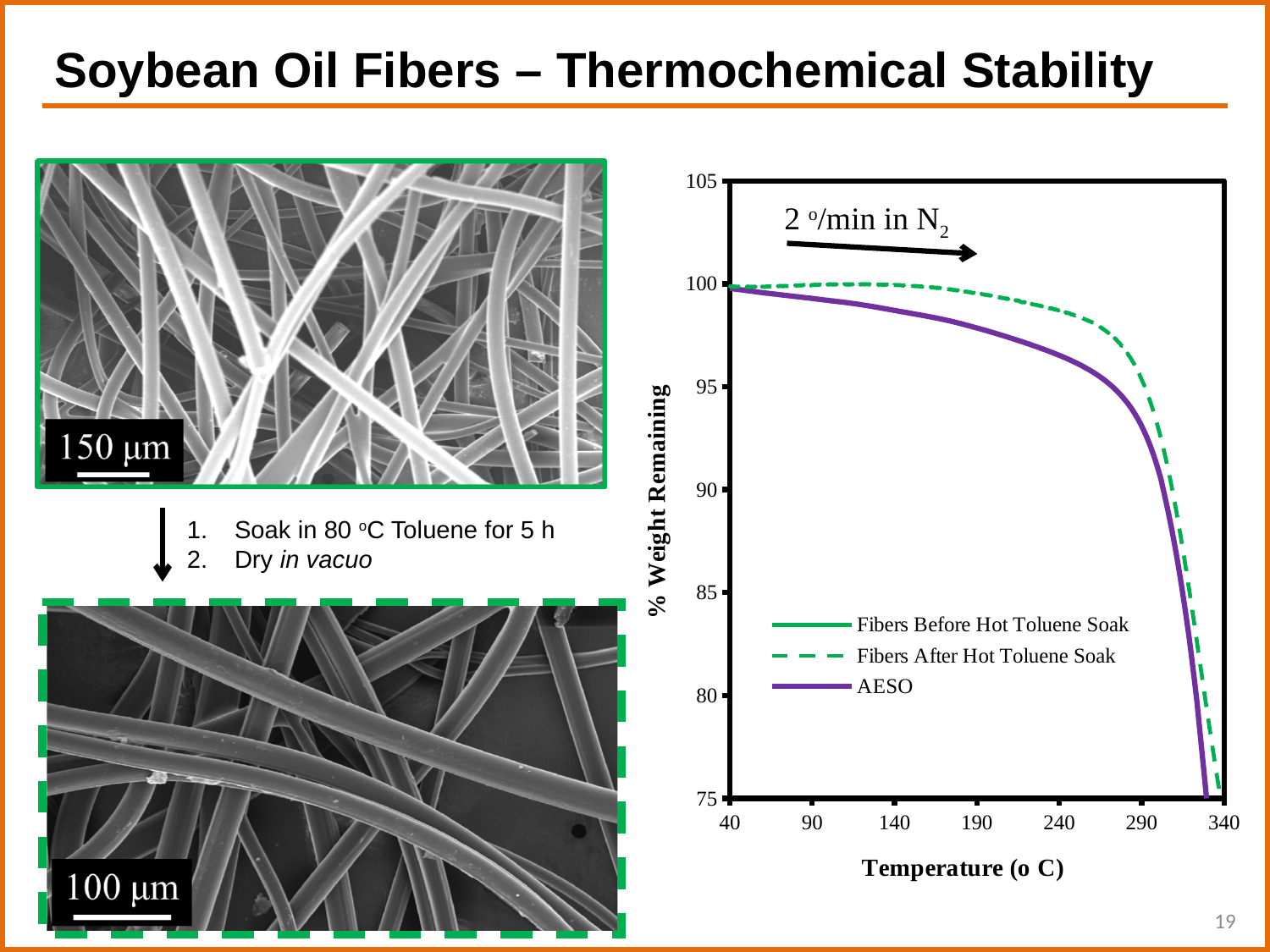
At 240 °C, which series has the higher % Weight Remaining, Fibers After Hot Toluene Soak or AESO? Fibers After Hot Toluene Soak Is the % Weight Remaining for AESO at 140 °C greater or less than 95? greater How many series does the legend of the chart list? 3 At 190 °C, which series has the lower % Weight Remaining, Fibers After Hot Toluene Soak or AESO? AESO Is the % Weight Remaining for AESO at 240 °C greater or less than 95? greater Is the % Weight Remaining for AESO at 330 °C greater or less than 90? less What is the title of the x axis of the chart? Temperature (o C) What kind of chart is shown on the right of the slide? line chart What is the title of the y axis of the chart? % Weight Remaining What is the highest temperature tick shown on the x axis of the chart? 340 Do the plotted % Weight Remaining values rise or fall as temperature increases along the x axis? fall